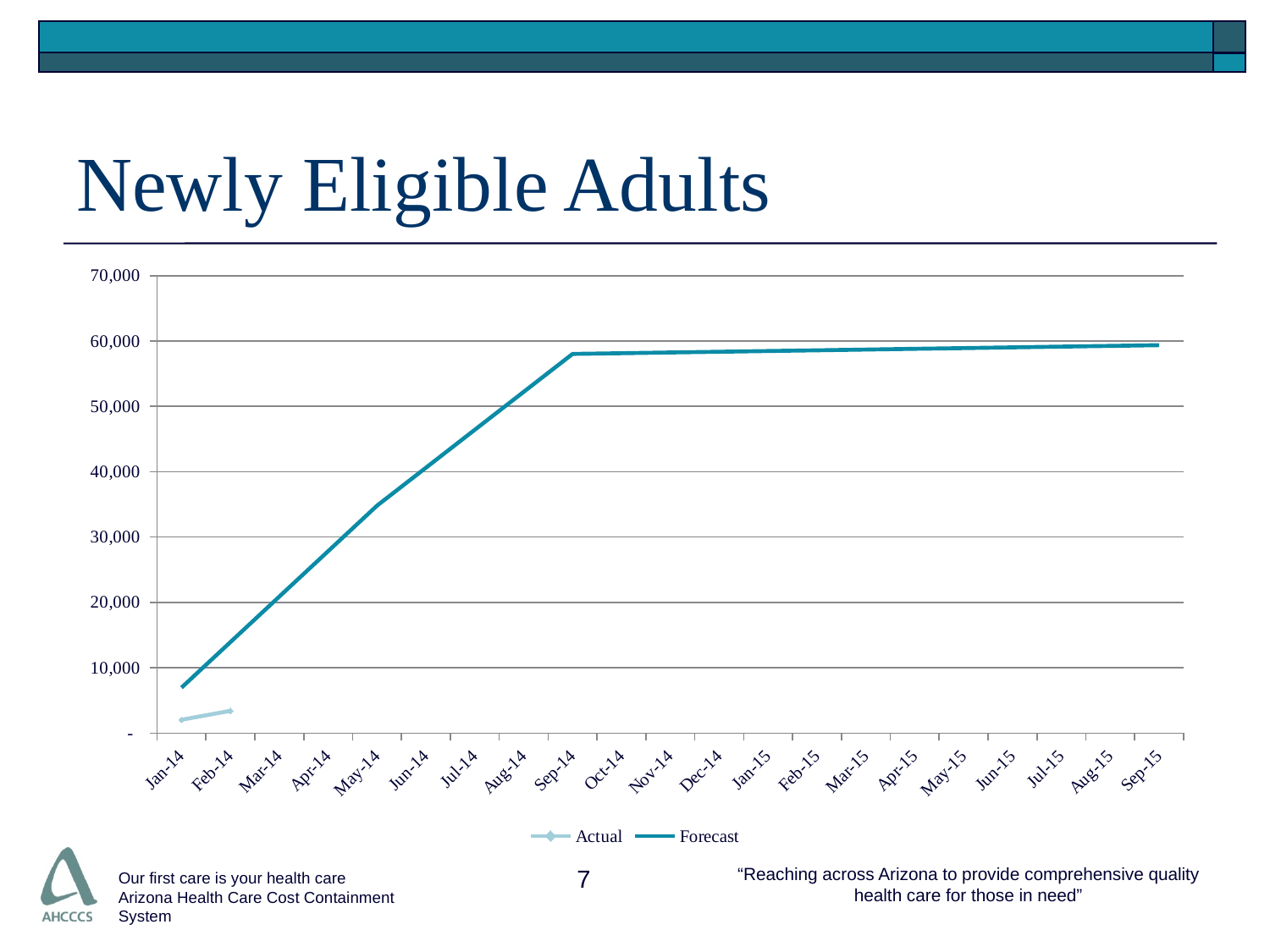
In Jan-14, which series has the larger value, Actual or Forecast? Forecast How many months are labelled along the x axis? 21 Is the Forecast value for May-14 greater or less than 30,000? greater Is the Actual value for Feb-14 greater or less than 10,000? less Does the Forecast line rise or fall from Jan-14 to Sep-14? Rise What are the two series named in the legend? Actual and Forecast Is the Forecast value for Jan-14 greater or less than 10,000? less What is the title of the chart? Newly Eligible Adults What kind of chart is shown on the slide? Line chart How many series does the legend list? 2 In which month is the Forecast value lowest? Jan-14